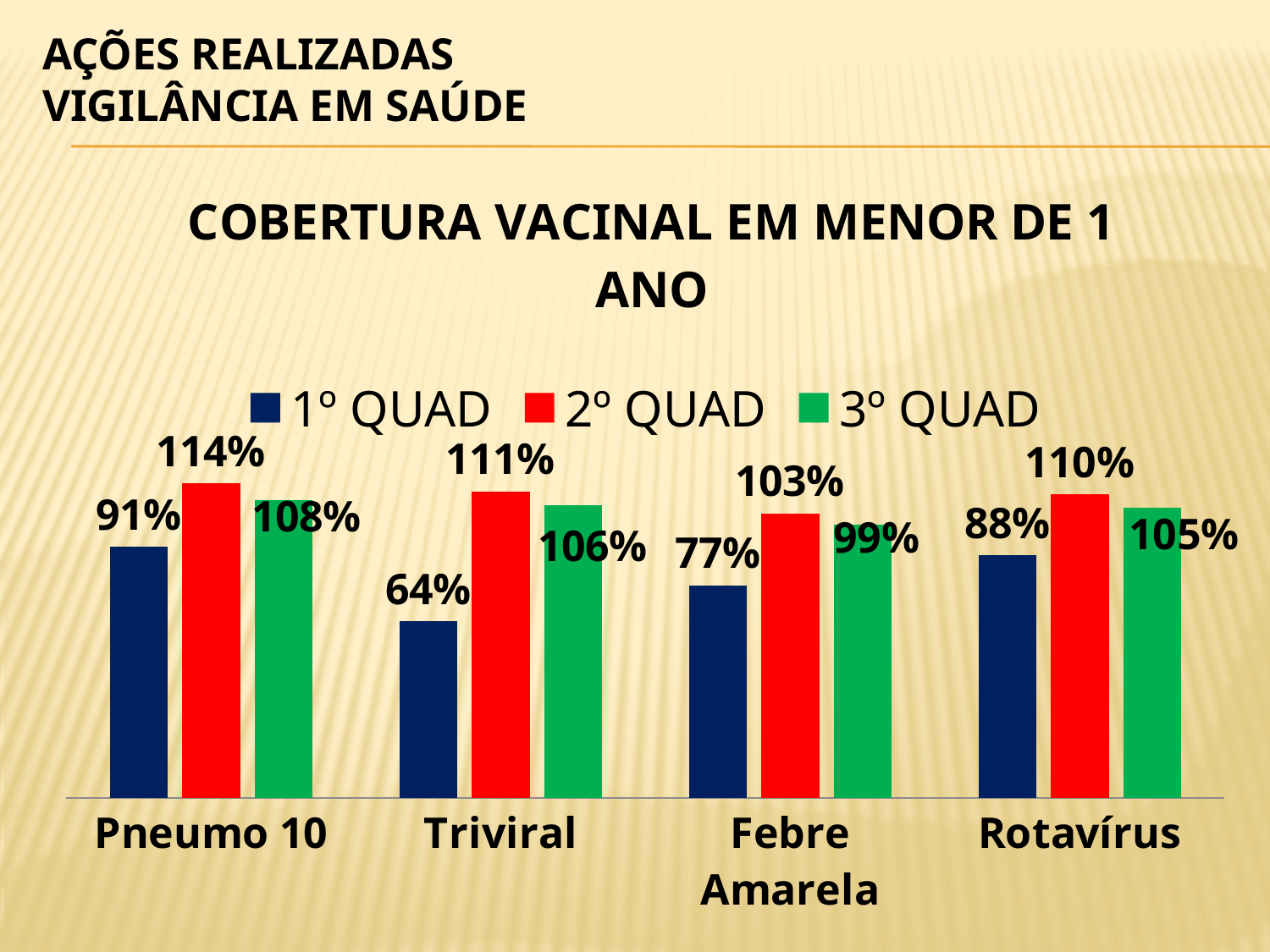
What is the difference between the 2º QUAD and 1º QUAD values for Triviral? 47% Which is larger for Febre Amarela: the 2º QUAD value or the 3º QUAD value? 2º QUAD What is the 1º QUAD value for Pneumo 10? 91% What is the 2º QUAD value for Triviral? 111% How many series does the legend list? 3 What is the 3º QUAD value for Febre Amarela? 99% What is the 1º QUAD value for Rotavírus? 88% Which vaccine has the highest 2º QUAD value? Pneumo 10 What kind of chart is shown? Bar chart How many vaccines are shown on the x axis? 4 Which vaccine has the lowest 1º QUAD value? Triviral What is the title of the chart? COBERTURA VACINAL EM MENOR DE 1 ANO